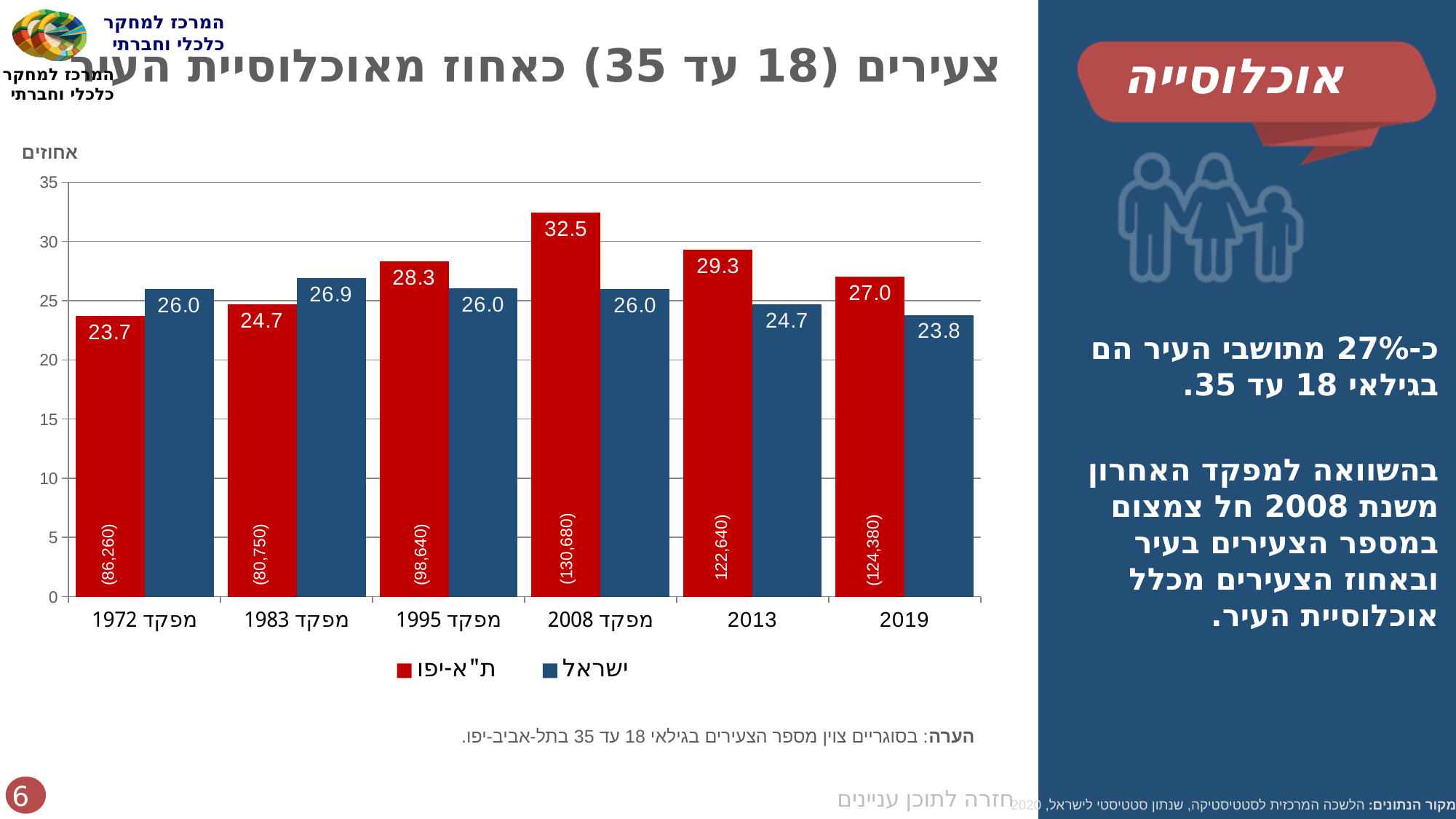
What is the difference between the ת"א-יפו and ישראל values in מפקד 2008? 6.5 How many categories are shown on the x axis? 6 What kind of chart is shown on the slide? bar chart How many series does the legend list? 2 In which category does ישראל have its lowest value? 2019 What number is printed inside the ת"א-יפו bar for מפקד 2008? (130,680) Which colour represents ת"א-יפו in the chart? red Which is larger in מפקד 1983: ת"א-יפו or ישראל? ישראל What is the value for ישראל in 2019? 23.8 What is the value for ת"א-יפו in מפקד 1972? 23.7 In which category does ת"א-יפו reach its highest value? מפקד 2008 What is the value for ת"א-יפו in מפקד 2008? 32.5